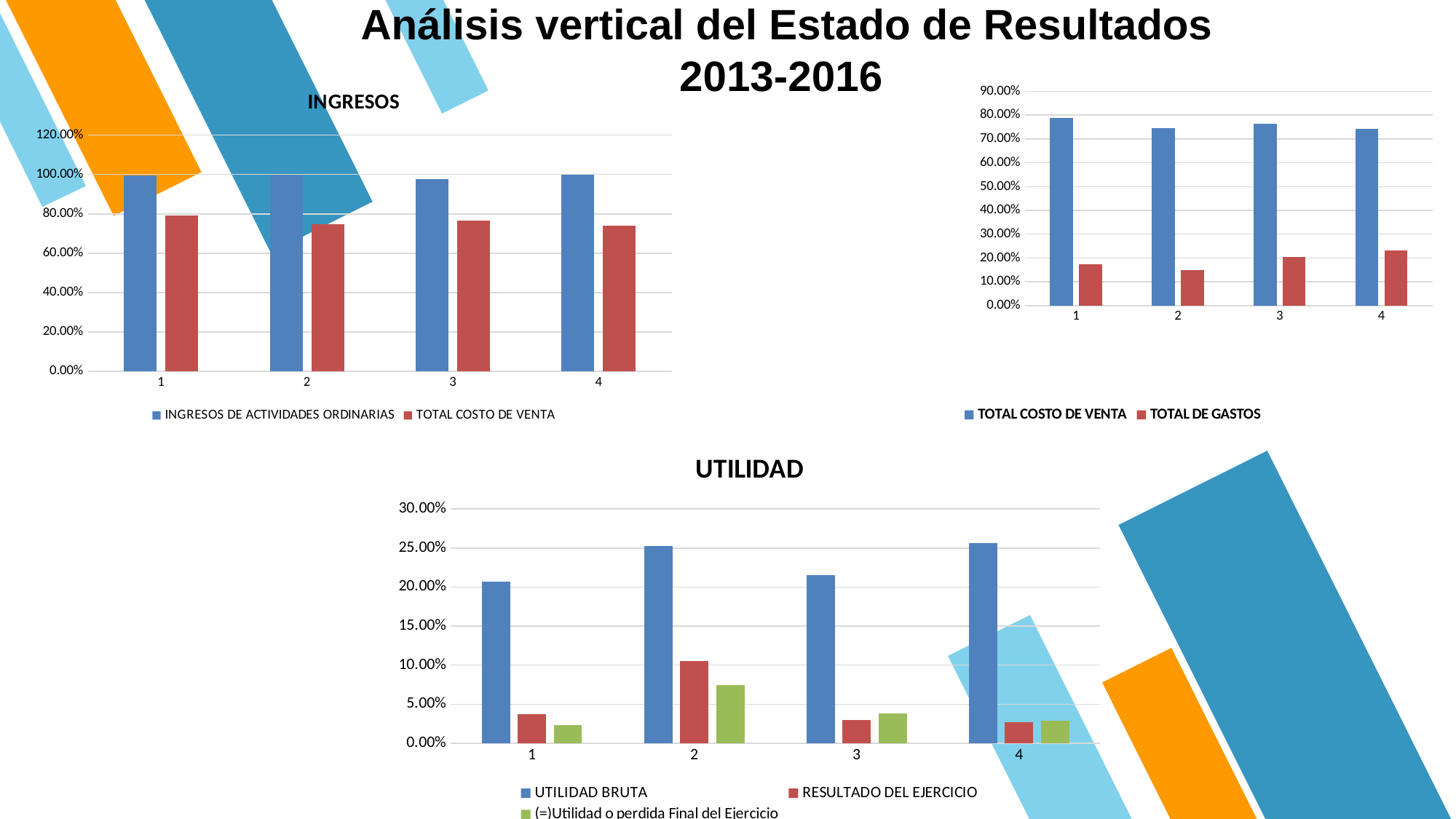
In the UTILIDAD chart, for category 2, which is larger: RESULTADO DEL EJERCICIO or (=)Utilidad o perdida Final del Ejercicio? RESULTADO DEL EJERCICIO How many categories are shown on the x axis of the INGRESOS chart? 4 How many series does the legend of the UTILIDAD chart list? 3 In the INGRESOS chart, which series has the taller bar for category 2, INGRESOS DE ACTIVIDADES ORDINARIAS or TOTAL COSTO DE VENTA? INGRESOS DE ACTIVIDADES ORDINARIAS In the top-right chart, is the value of TOTAL COSTO DE VENTA for category 1 greater or less than 70.00%? greater In the UTILIDAD chart, is the value of UTILIDAD BRUTA for category 2 greater or less than 20.00%? greater What kind of chart is the INGRESOS chart? bar chart In the UTILIDAD chart, which category has the highest value for RESULTADO DEL EJERCICIO? 2 In the INGRESOS chart, is the value of TOTAL COSTO DE VENTA for category 1 greater or less than 60.00%? greater What are the two series listed in the legend of the top-right chart? TOTAL COSTO DE VENTA and TOTAL DE GASTOS In the UTILIDAD chart, which category has the highest value for (=)Utilidad o perdida Final del Ejercicio? 2